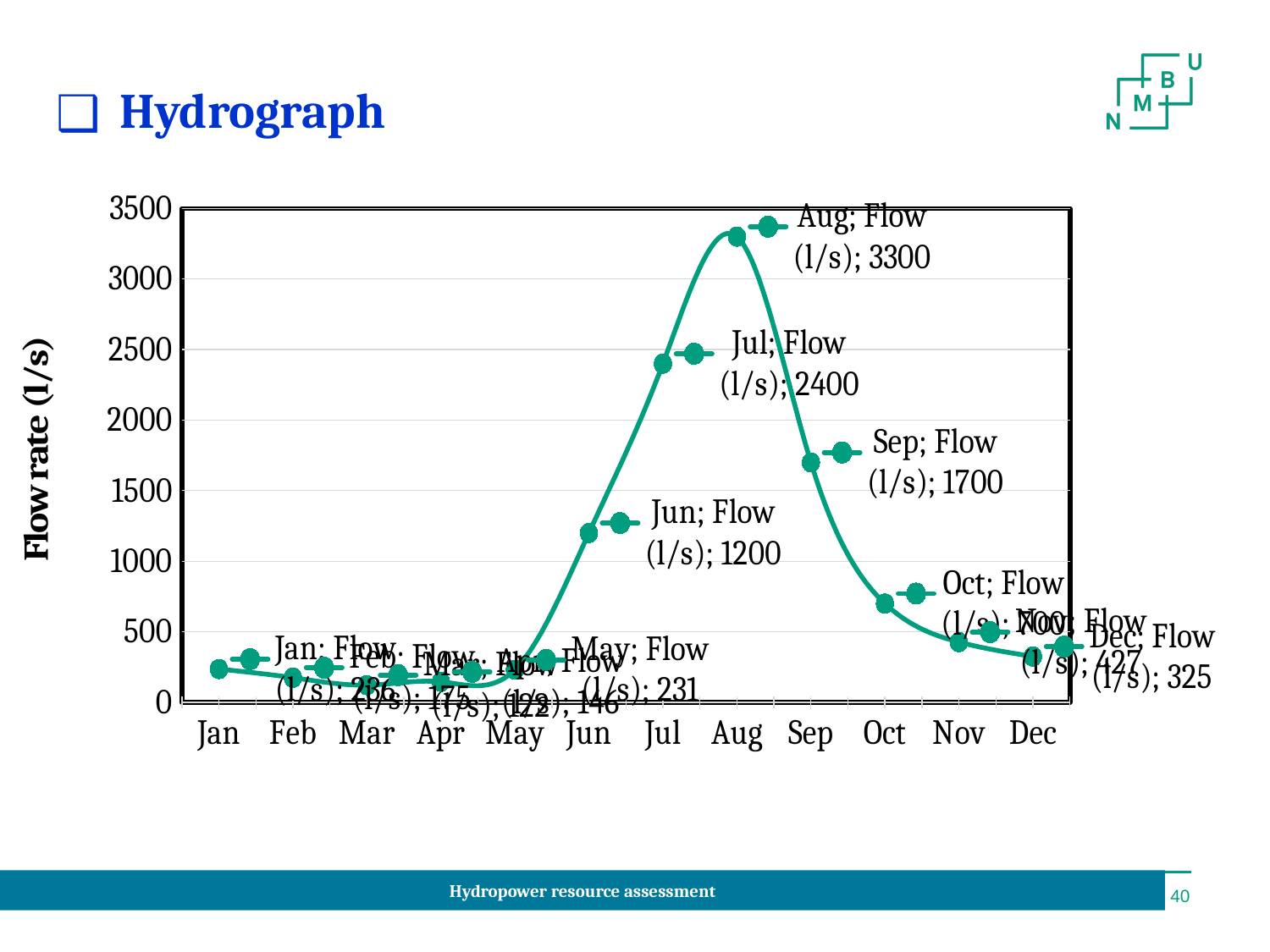
Is the flow rate for Oct greater or less than 1000? less What is the difference between the flow rates for Aug and Jul? 900 What is the flow rate for Sep? 1700 What is the flow rate for Jul? 2400 What is the flow rate for Aug? 3300 What is the flow rate for Dec? 325 How many months are plotted on the x axis? 12 Which month has a higher flow rate, Jul or Sep? Jul Which month has the highest flow rate? Aug What is the flow rate for Jun? 1200 What kind of chart is shown on the slide? line chart Do the flow rate values rise or fall from Aug to Dec? fall